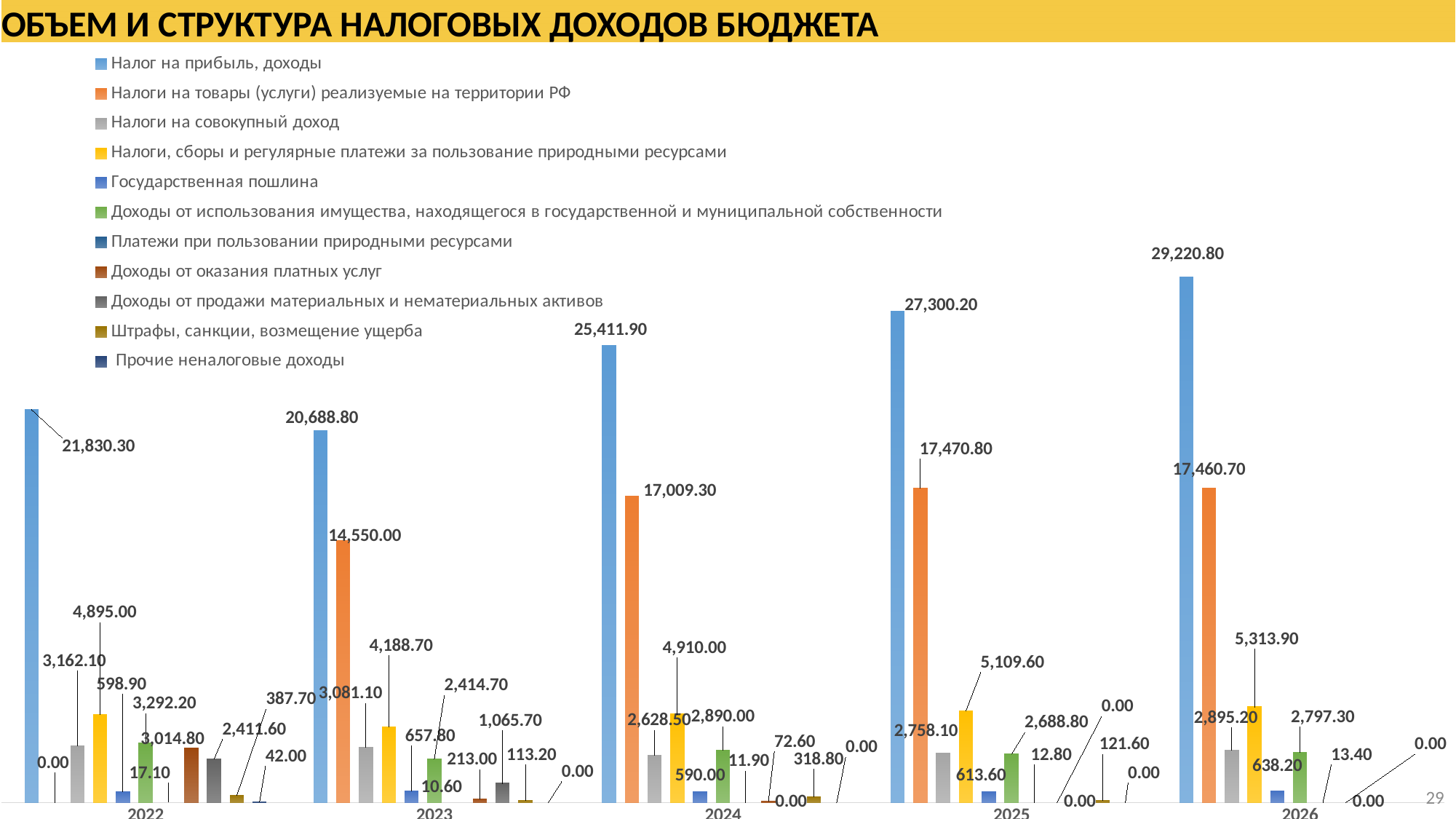
What is the value of 'Налог на прибыль, доходы' for 2022? 21,830.30 What is the value of 'Налог на прибыль, доходы' for 2026? 29,220.80 What is the difference between 'Налог на прибыль, доходы' in 2026 and in 2025? 1,920.60 How many years are shown on the x axis? 5 Which is larger: 'Налог на прибыль, доходы' in 2024 or in 2023? 2024 What is the title of the slide? ОБЪЕМ И СТРУКТУРА НАЛОГОВЫХ ДОХОДОВ БЮДЖЕТА What kind of chart is shown on the slide? Bar chart What is the value of 'Налоги на товары (услуги) реализуемые на территории РФ' for 2024? 17,009.30 What is the value of 'Налоги, сборы и регулярные платежи за пользование природными ресурсами' for 2025? 5,109.60 How many series does the legend list? 11 In which year is 'Налог на прибыль, доходы' highest? 2026 In which year is 'Налог на прибыль, доходы' lowest? 2023